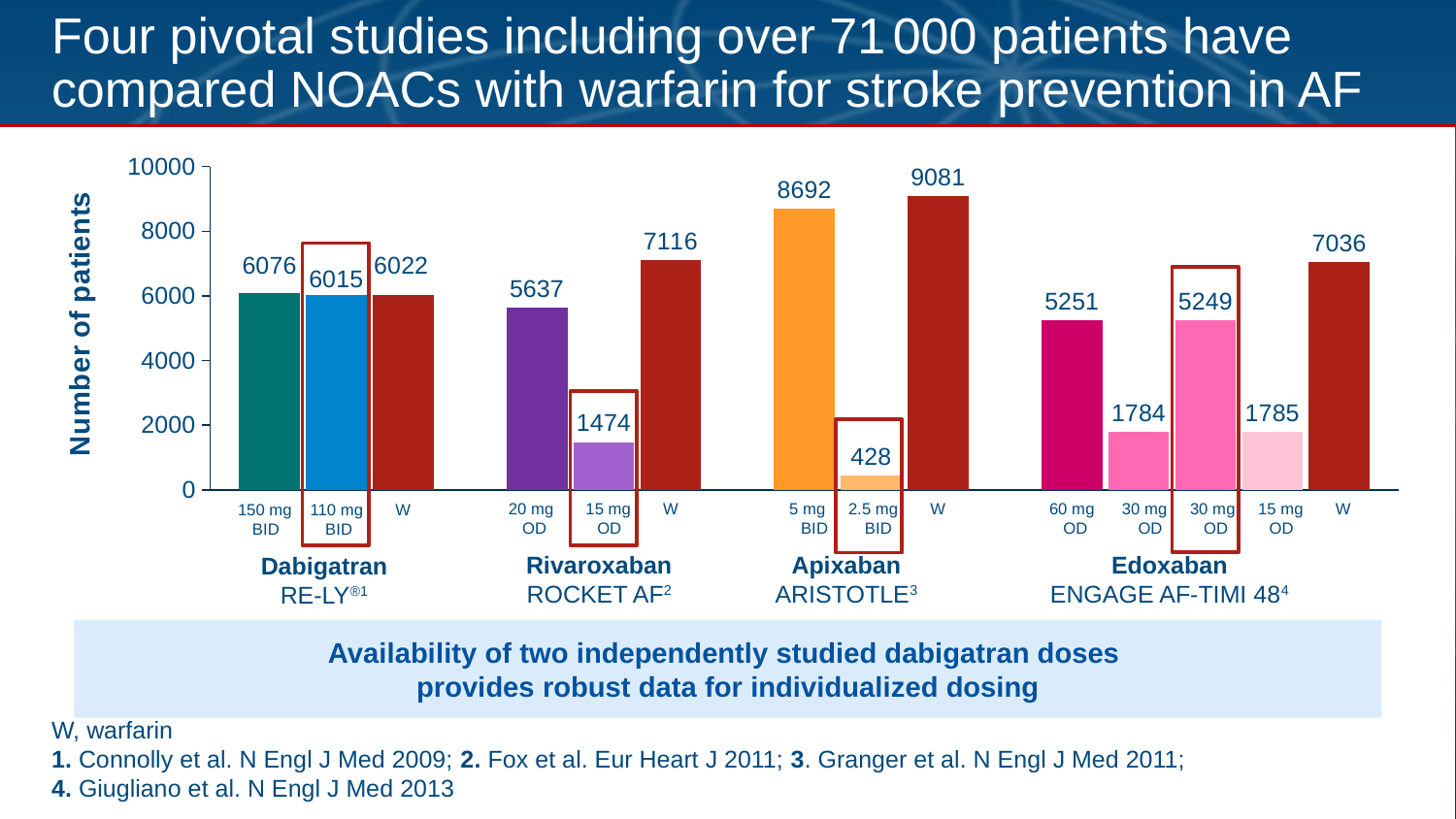
What is the difference in patient numbers between the rivaroxaban 20 mg OD and 15 mg OD arms? 4163 Which bar on the chart has the highest number of patients? Warfarin (W) in ARISTOTLE, 9081 What is the number of patients in the warfarin arm of ROCKET AF? 7116 What type of chart is shown on the slide? Bar chart How many patients received dabigatran 150 mg BID in RE-LY? 6076 How many patients received apixaban 2.5 mg BID in ARISTOTLE? 428 What is the total number of patients across the three arms of RE-LY? 18113 How many bars are plotted on the chart in total? 14 Which bar on the chart has the lowest number of patients? Apixaban 2.5 mg BID, 428 Which arm had more patients: edoxaban 60 mg OD or the warfarin arm of ENGAGE AF-TIMI 48? Warfarin (W), 7036 What is the label of the y-axis on the chart? Number of patients Is the number of patients in the apixaban 5 mg BID arm greater or less than 8000? greater